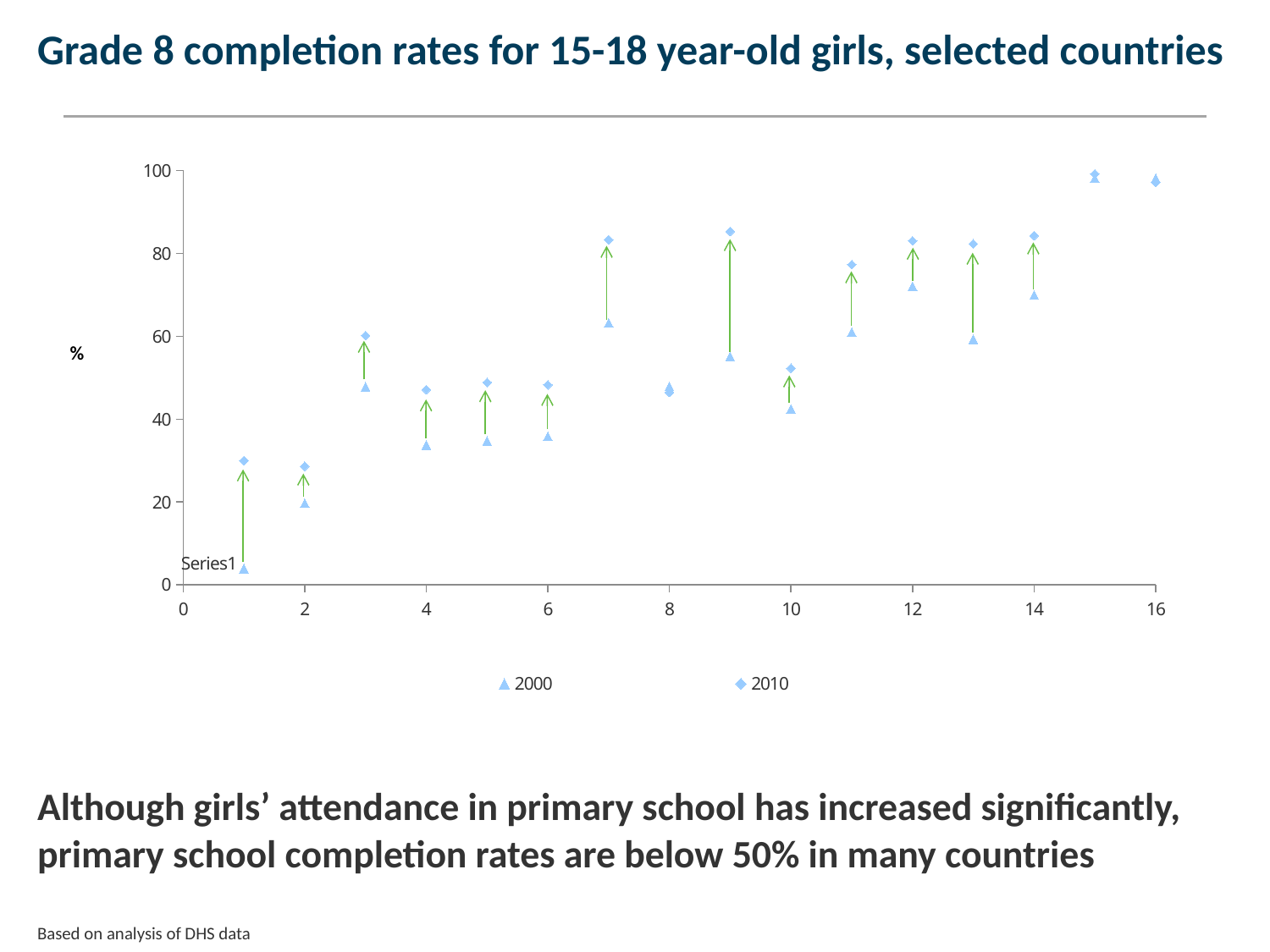
What kind of chart is shown on the slide? scatter chart What are the two series named in the legend? 2000 and 2010 How many series does the legend list? 2 Is the 2010 value at x = 9 greater or less than 80? greater Is the 2010 value at x = 15 greater or less than 80? greater Is the 2000 value at x = 4 greater or less than 40? less At x = 9, which series has the larger value, 2000 or 2010? 2010 Which x-axis position has the lowest 2000 value? 1 What is the title of the chart? Grade 8 completion rates for 15-18 year-old girls, selected countries How many countries (x-axis positions) are plotted in the chart? 16